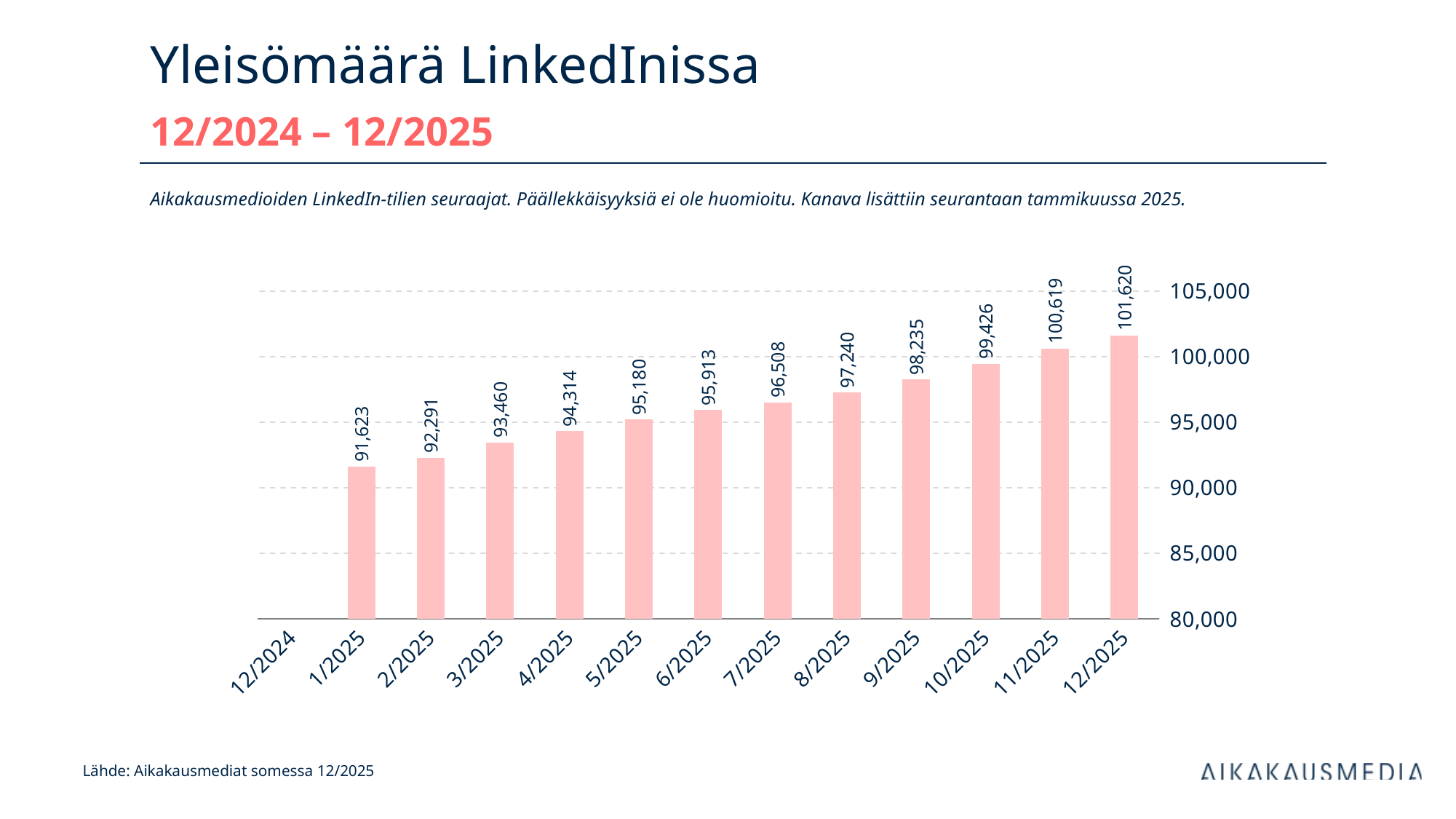
What is the difference between the values for 11/2025 and 10/2025? 1,193 What is the value for 7/2025? 96,508 What kind of chart is shown on the slide? bar chart Which month with a bar has the lowest value? 1/2025 How many bars are plotted in the chart? 12 Is the value for 8/2025 greater or less than 95,000? greater Which month has the highest value? 12/2025 Which is larger, the value for 3/2025 or the value for 9/2025? 9/2025 What is the value for 12/2025? 101,620 What is the value for 1/2025? 91,623 Do the values rise or fall from 1/2025 to 12/2025? rise What is the difference between the values for 12/2025 and 1/2025? 9,997